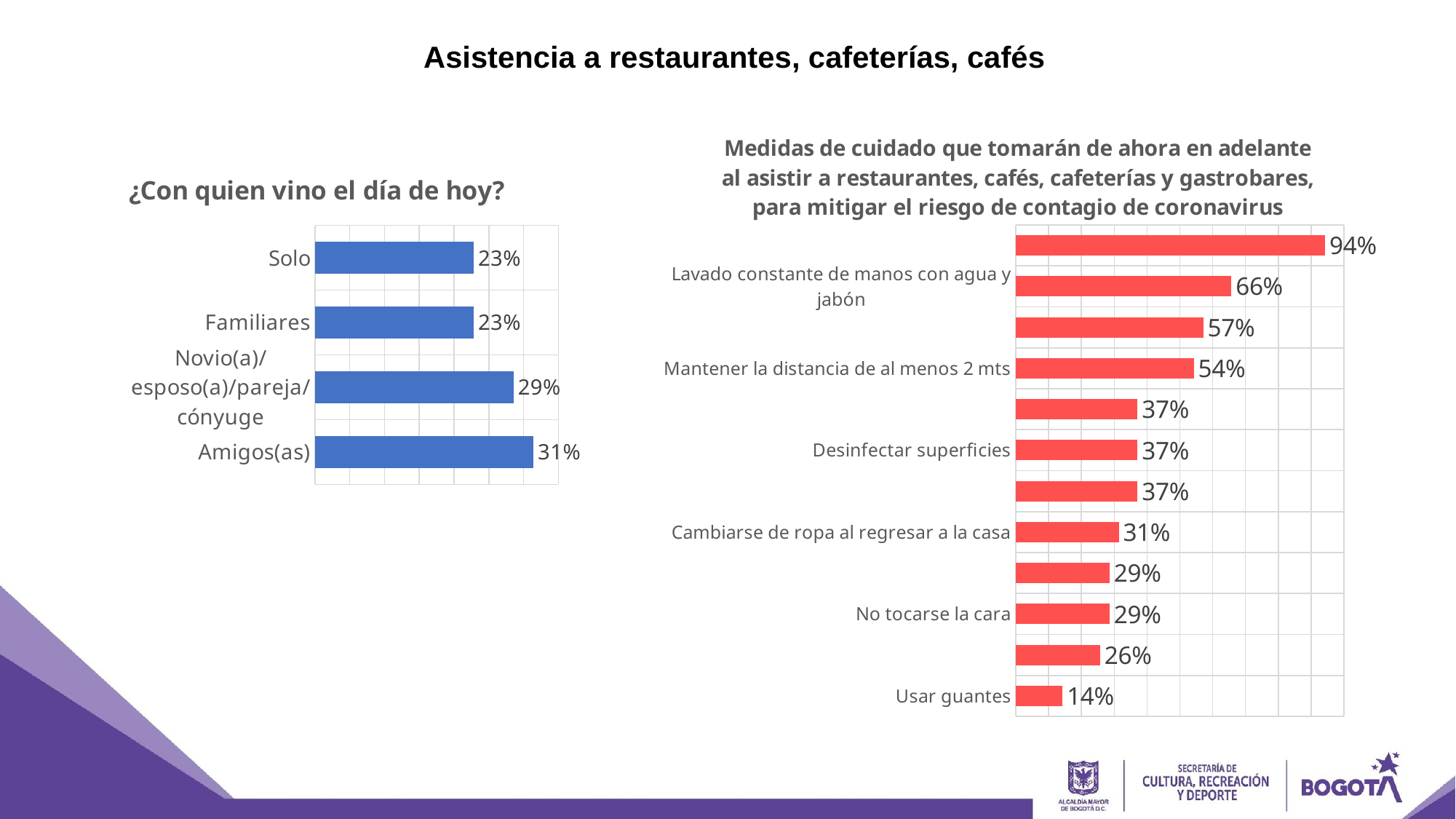
In the chart 'Medidas de cuidado que tomarán de ahora en adelante...', which is larger: Desinfectar superficies or No tocarse la cara? Desinfectar superficies In the chart '¿Con quien vino el día de hoy?', what is the value for Amigos(as)? 31% In the chart 'Medidas de cuidado que tomarán de ahora en adelante...', what is the highest value shown? 94% In the chart '¿Con quien vino el día de hoy?', which category has the highest value? Amigos(as) In the chart 'Medidas de cuidado que tomarán de ahora en adelante...', what is the value for Cambiarse de ropa al regresar a la casa? 31% In the chart 'Medidas de cuidado que tomarán de ahora en adelante...', how many bars are shown? 12 In the chart '¿Con quien vino el día de hoy?', what is the difference between the values for Amigos(as) and Solo? 8 percentage points In the chart '¿Con quien vino el día de hoy?', what is the value for Novio(a)/esposo(a)/pareja/cónyuge? 29% In the chart 'Medidas de cuidado que tomarán de ahora en adelante...', what is the value for Mantener la distancia de al menos 2 mts? 54% In the chart '¿Con quien vino el día de hoy?', what kind of chart is used? Bar chart In the chart 'Medidas de cuidado que tomarán de ahora en adelante...', what is the value for Usar guantes? 14% In the chart '¿Con quien vino el día de hoy?', how many categories are shown? 4